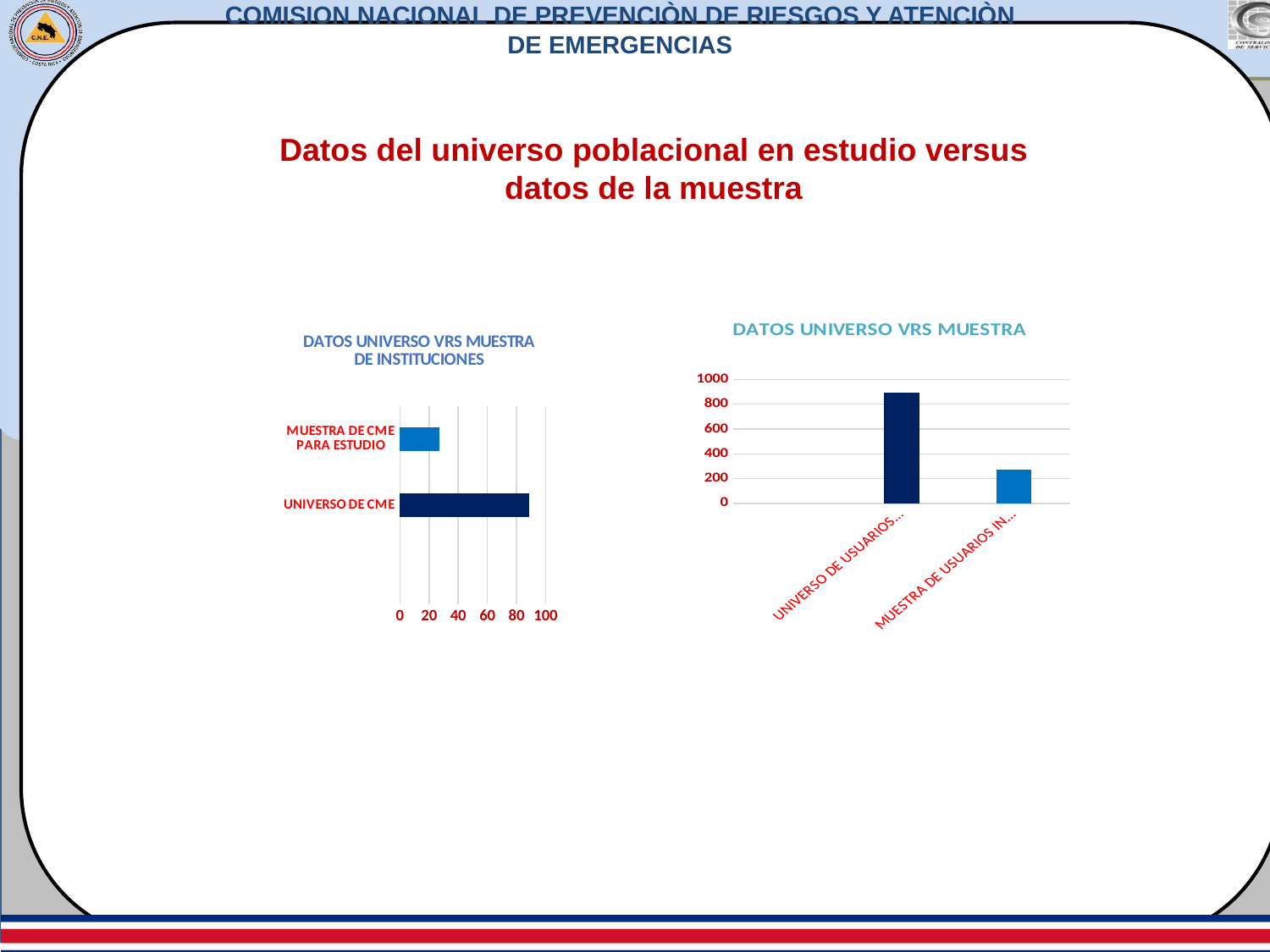
In the left chart 'DATOS UNIVERSO VRS MUESTRA DE INSTITUCIONES', which category has the highest value? UNIVERSO DE CME What kind of chart is the chart titled 'DATOS UNIVERSO VRS MUESTRA DE INSTITUCIONES' on the left? bar chart In the right chart 'DATOS UNIVERSO VRS MUESTRA', which bar is taller, the left bar (UNIVERSO DE USUARIOS...) or the right bar (MUESTRA DE USUARIOS IN...)? the left bar (UNIVERSO DE USUARIOS...) In the left chart 'DATOS UNIVERSO VRS MUESTRA DE INSTITUCIONES', is the value for MUESTRA DE CME PARA ESTUDIO greater or less than 40? less In the left chart 'DATOS UNIVERSO VRS MUESTRA DE INSTITUCIONES', is the value for UNIVERSO DE CME greater or less than 80? greater In the right chart 'DATOS UNIVERSO VRS MUESTRA', is the value of the left bar (UNIVERSO DE USUARIOS...) greater or less than 800? greater What kind of chart is the chart titled 'DATOS UNIVERSO VRS MUESTRA' on the right? bar chart In the right chart 'DATOS UNIVERSO VRS MUESTRA', how many bars are plotted? 2 In the left chart 'DATOS UNIVERSO VRS MUESTRA DE INSTITUCIONES', how many categories are plotted? 2 What is the highest value shown on the vertical axis of the right chart 'DATOS UNIVERSO VRS MUESTRA'? 1000 In the left chart 'DATOS UNIVERSO VRS MUESTRA DE INSTITUCIONES', which category has the lowest value? MUESTRA DE CME PARA ESTUDIO